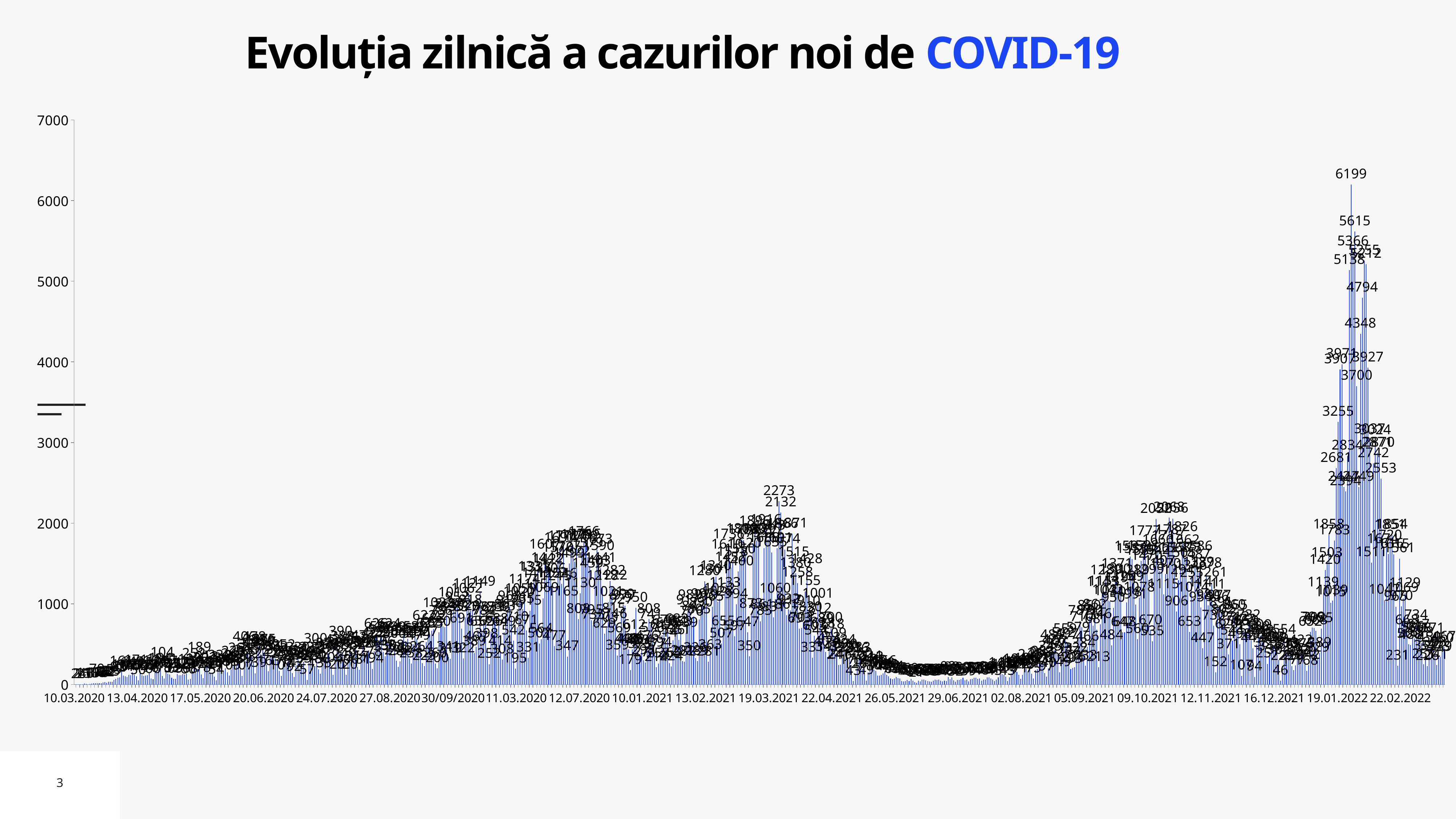
Do the values generally rise or fall between 22.04.2021 and 26.05.2021? fall What is the title of the chart? Evoluția zilnică a cazurilor noi de COVID-19 What is the highest daily value labelled on the chart? 6199 What is the second-highest value labelled on the chart, just below the 6199 peak? 5615 What is the highest tick value shown on the vertical axis? 7000 What is the highest value labelled in the peak around 19.03.2021? 2273 What kind of chart is shown on the slide? bar chart Is the highest peak on the chart greater or less than 6000? greater Which is larger, the peak around 19.03.2021 (2273) or the peak in early 2022 (6199)? 6199 Do the values generally rise or fall between 05.09.2021 and 09.10.2021? rise What is the difference between the highest labelled value (6199) and the second-highest labelled value (5615)? 584 Are the daily values around 29.06.2021 greater or less than 1000? less